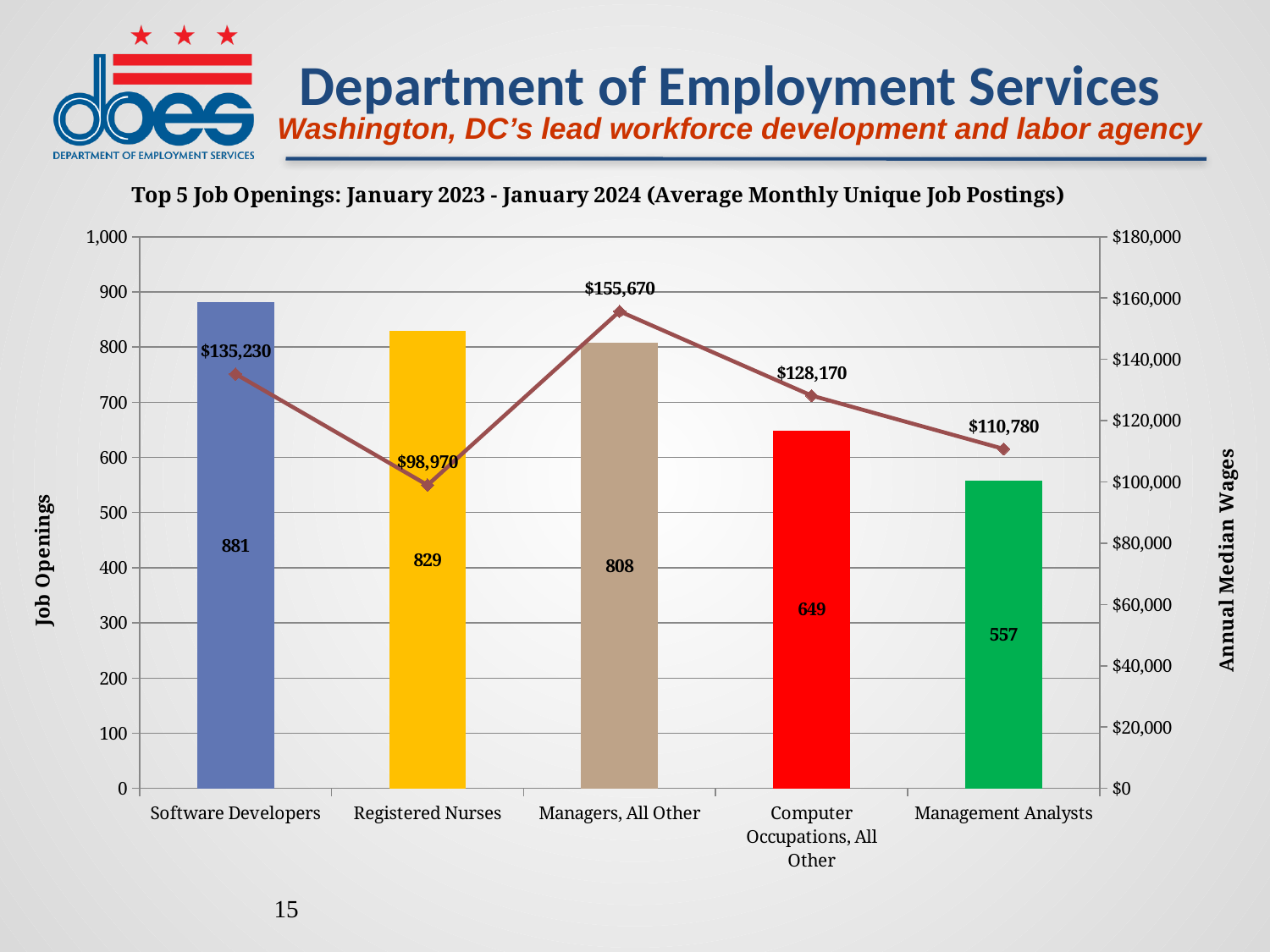
Which occupation has the highest number of job openings? Software Developers What is the difference in job openings between Software Developers and Management Analysts? 324 Which has more job openings, Registered Nurses or Computer Occupations, All Other? Registered Nurses What is the title of the chart? Top 5 Job Openings: January 2023 - January 2024 (Average Monthly Unique Job Postings) What is the annual median wage shown for Registered Nurses? $98,970 What is the annual median wage shown for Managers, All Other? $155,670 What is the number of job openings for Software Developers? 881 Which occupation has the lowest number of job openings? Management Analysts Which occupation has the lowest annual median wage? Registered Nurses What is the difference in annual median wages between Managers, All Other and Computer Occupations, All Other? $27,500 How many occupations are shown on the chart? 5 Is the number of job openings for Managers, All Other greater or less than 700? greater